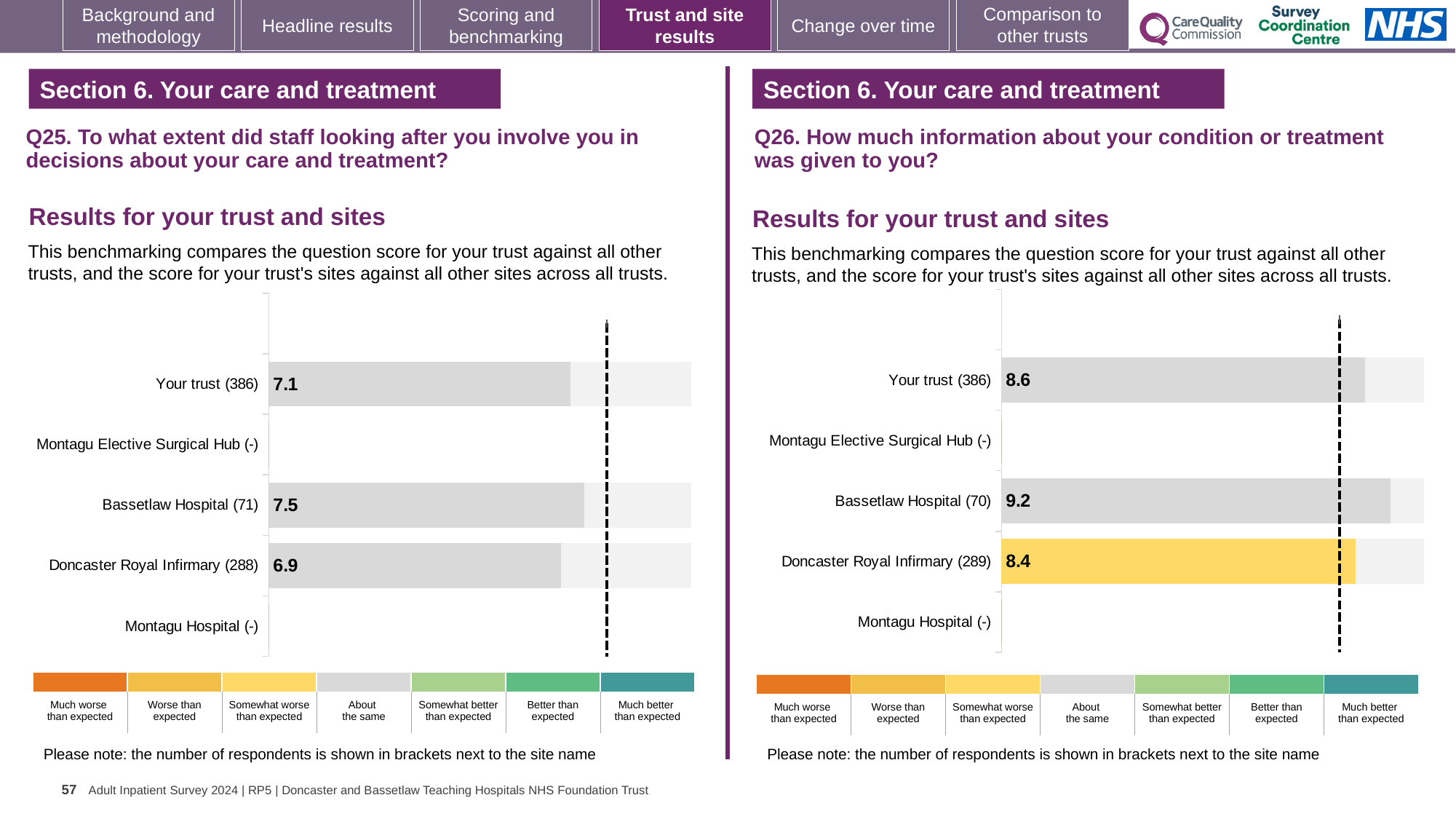
What type of chart is used on the Q26 chart (right)? Bar chart On the Q25 chart (left), what is the score for Your trust (386)? 7.1 On the Q26 chart (right), which site or trust has the highest score? Bassetlaw Hospital (70) How many site or trust rows are listed on the Q25 chart (left)? 5 On the Q25 chart (left), how many respondents are shown for Your trust? 386 On the Q26 chart (right), what is the difference between the scores for Bassetlaw Hospital and Your trust? 0.6 On the Q26 chart (right), which site's bar is coloured yellow, indicating 'Somewhat worse than expected'? Doncaster Royal Infirmary (289) On the Q25 chart (left), what is the score for Bassetlaw Hospital (71)? 7.5 On the Q26 chart (right), which has the larger score, Your trust or Doncaster Royal Infirmary? Your trust On the Q26 chart (right), what is the score for Doncaster Royal Infirmary (289)? 8.4 On the Q25 chart (left), what is the difference between the scores for Bassetlaw Hospital and Doncaster Royal Infirmary? 0.6 On the Q25 chart (left), which site or trust has the lowest score? Doncaster Royal Infirmary (288)